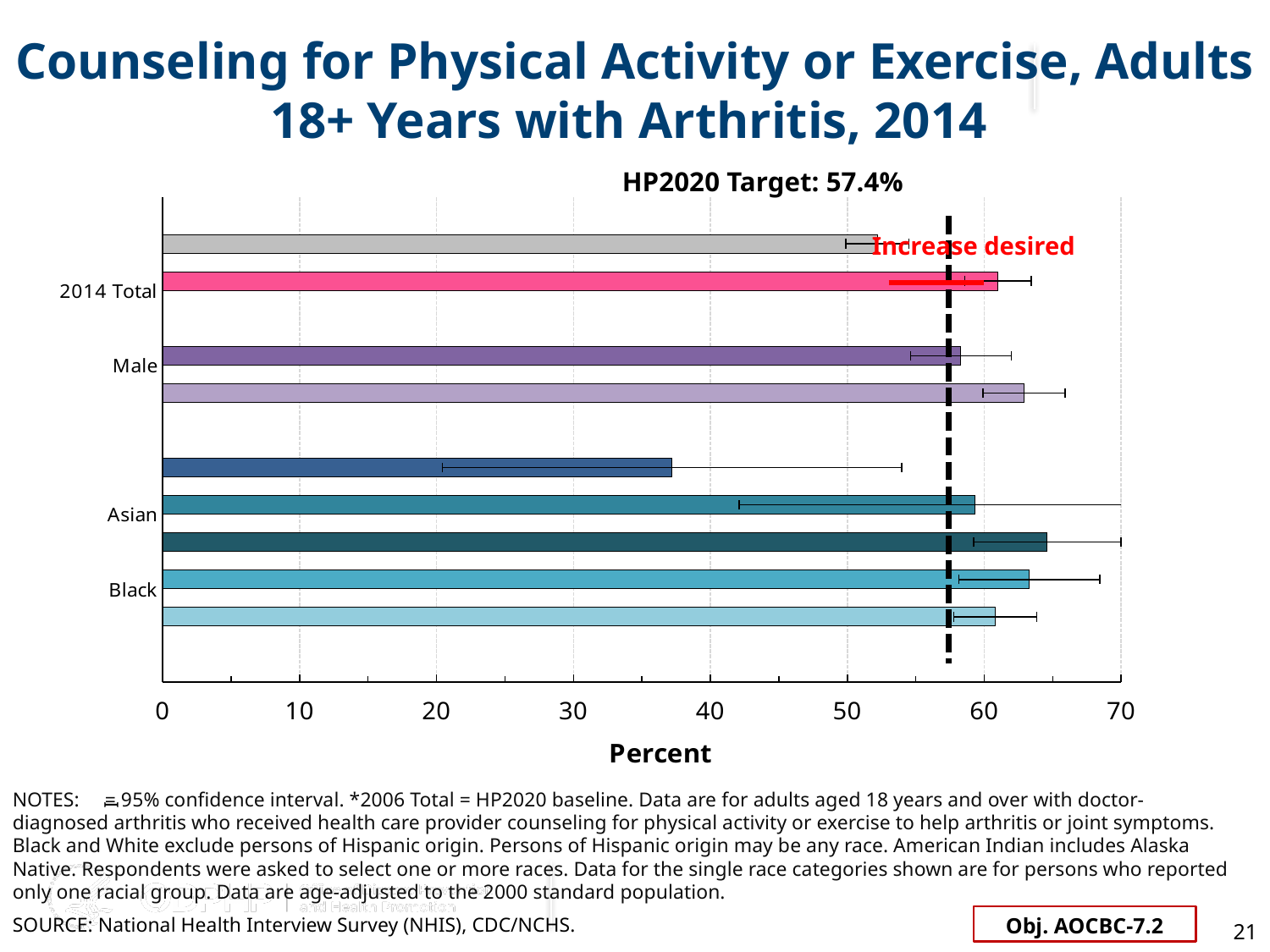
Is the value for Asian greater or less than 50? greater What is the label of the horizontal axis? Percent What kind of chart is shown on the slide? bar chart What is the HP2020 Target value shown above the chart? 57.4% Is the value for Male greater or less than 50? greater Is the value for Black greater or less than 60? greater Is the 2014 Total bar above or below the HP2020 Target line? above Which has the larger value, Black or Asian? Black Which has the larger value, Black or Male? Black What is the highest value shown on the horizontal axis? 70 How many bars are plotted in the chart? 9